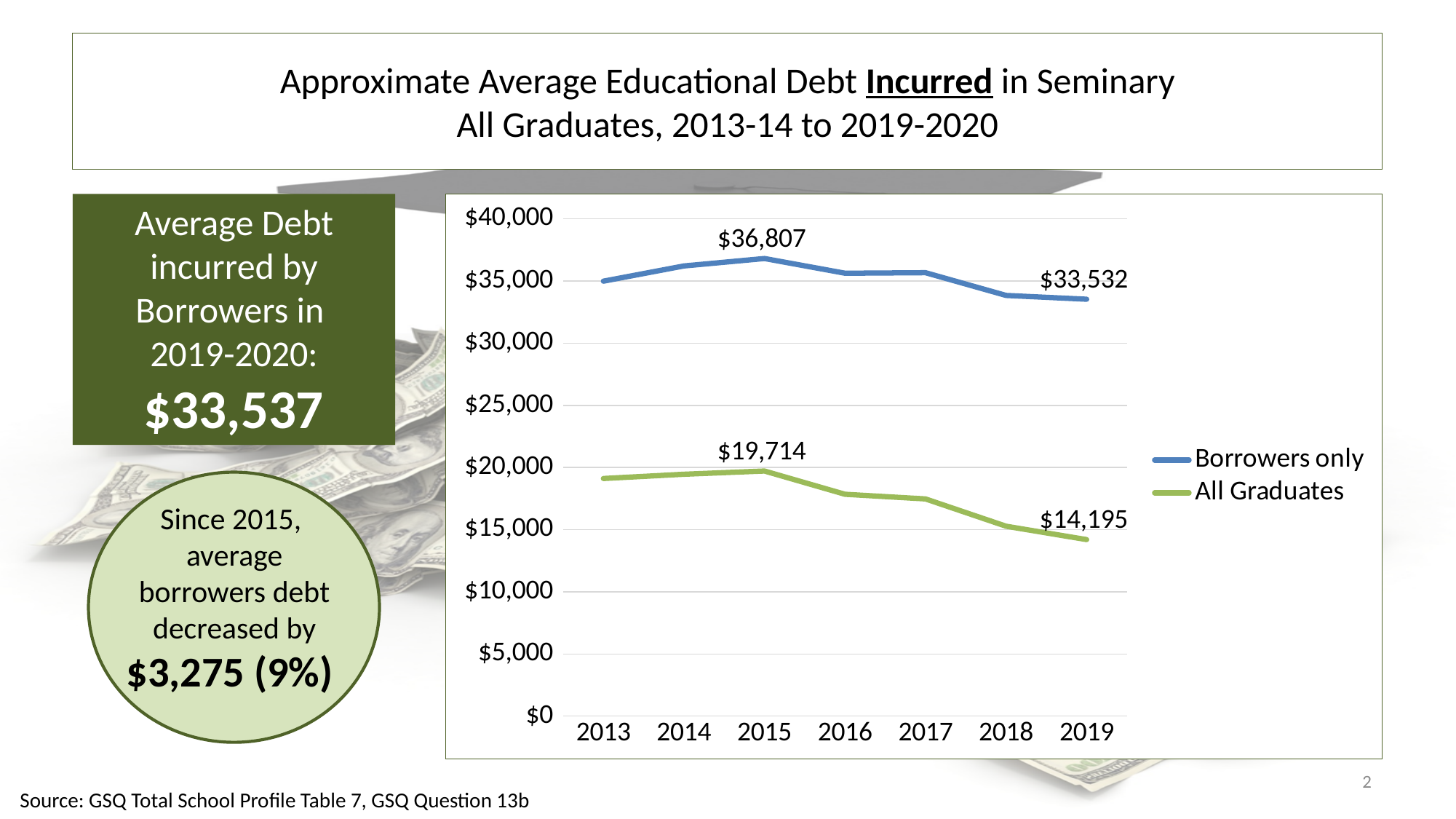
Is the value for All Graduates in 2016 greater or less than $20,000? less How many series does the legend list? 2 In which year is the Borrowers only line at its highest? 2015 What is the difference between the Borrowers only and All Graduates values in 2019? $19,337 What is the difference between the Borrowers only values in 2015 and 2019? $3,275 What is the value for Borrowers only in 2019? $33,532 What is the value for All Graduates in 2019? $14,195 What kind of chart is shown on the slide? line chart Which series has the larger value in 2017, Borrowers only or All Graduates? Borrowers only In which year is the All Graduates line at its lowest? 2019 How many years are shown on the x axis? 7 What is the value for Borrowers only in 2015? $36,807